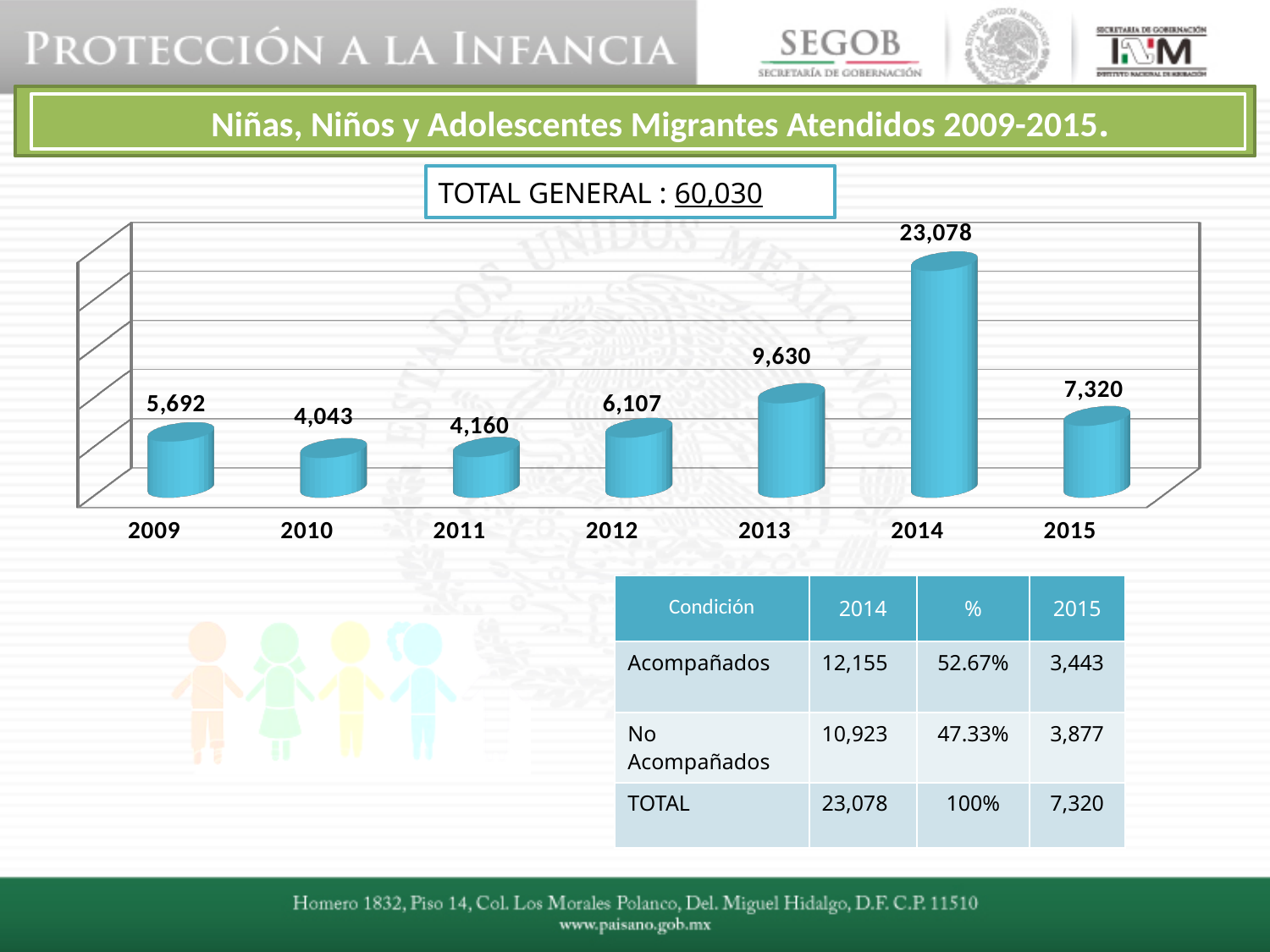
What is the title of the chart on the slide? Niñas, Niños y Adolescentes Migrantes Atendidos 2009-2015. What kind of chart is shown on the slide? bar chart How many years are shown on the x axis of the chart? 7 Which year has the highest value in the chart? 2014 What is the value for 2012 in the chart? 6,107 Which year has the lowest value in the chart? 2010 What is the difference between the values for 2011 and 2010? 117 What is the value for 2009 in the chart? 5,692 Which is larger, the value for 2015 or the value for 2012? 2015 Do the values rise or fall from 2011 to 2014? rise What is the value for 2014 in the chart? 23,078 What is the difference between the values for 2014 and 2013? 13,448